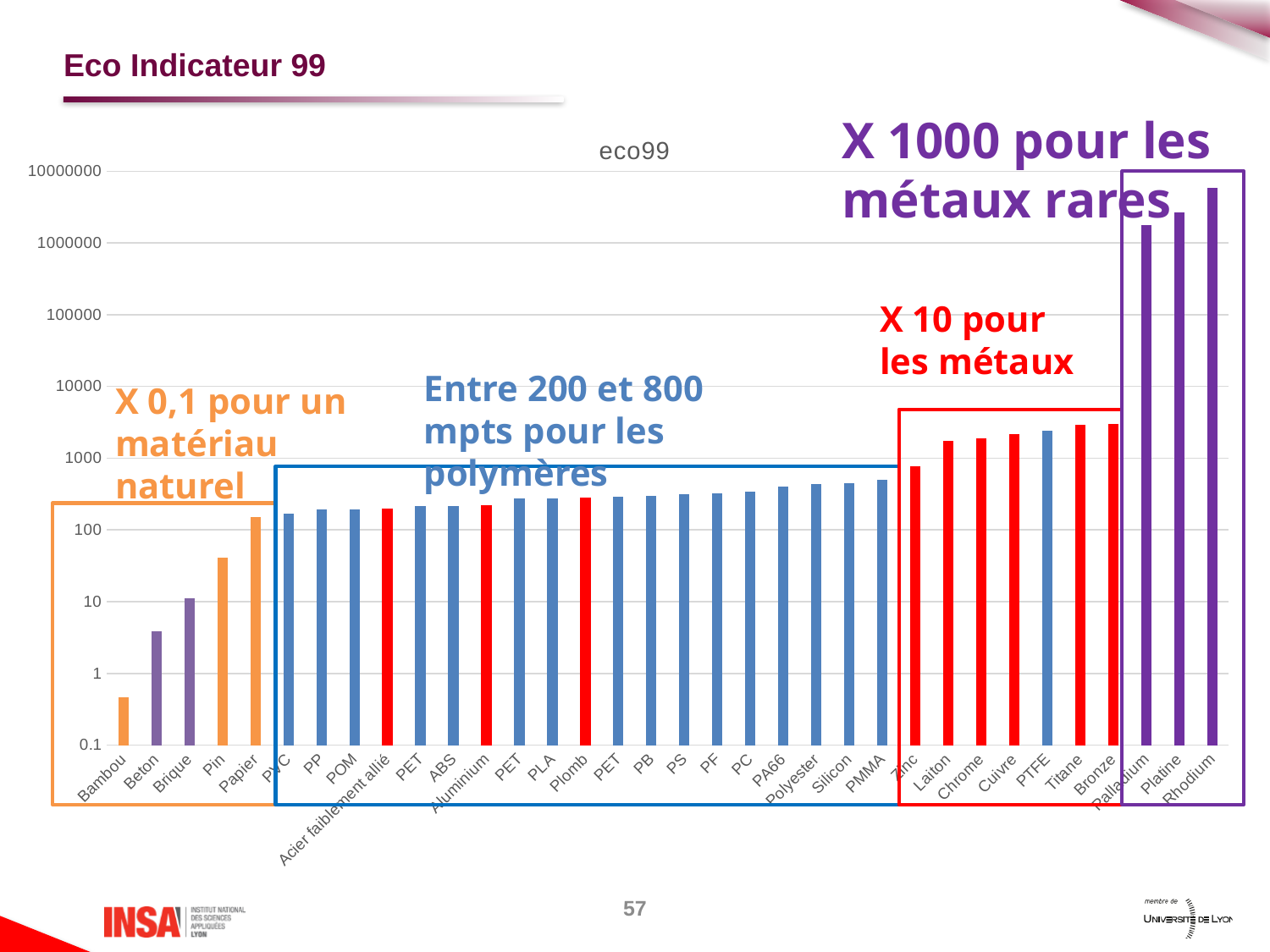
Is the value for Zinc greater or less than 1000? less What kind of chart is shown on the slide? bar chart Which category has the highest value in the chart? Rhodium Is the value for Pin greater or less than 10? greater Is the value for Bambou greater or less than 1? less Which category has the lowest value in the chart? Bambou Do the values generally rise or fall from left to right along the x axis? rise How many categories are plotted in the chart? 34 Which has the larger value, Titane or Zinc? Titane What is the title of the chart? eco99